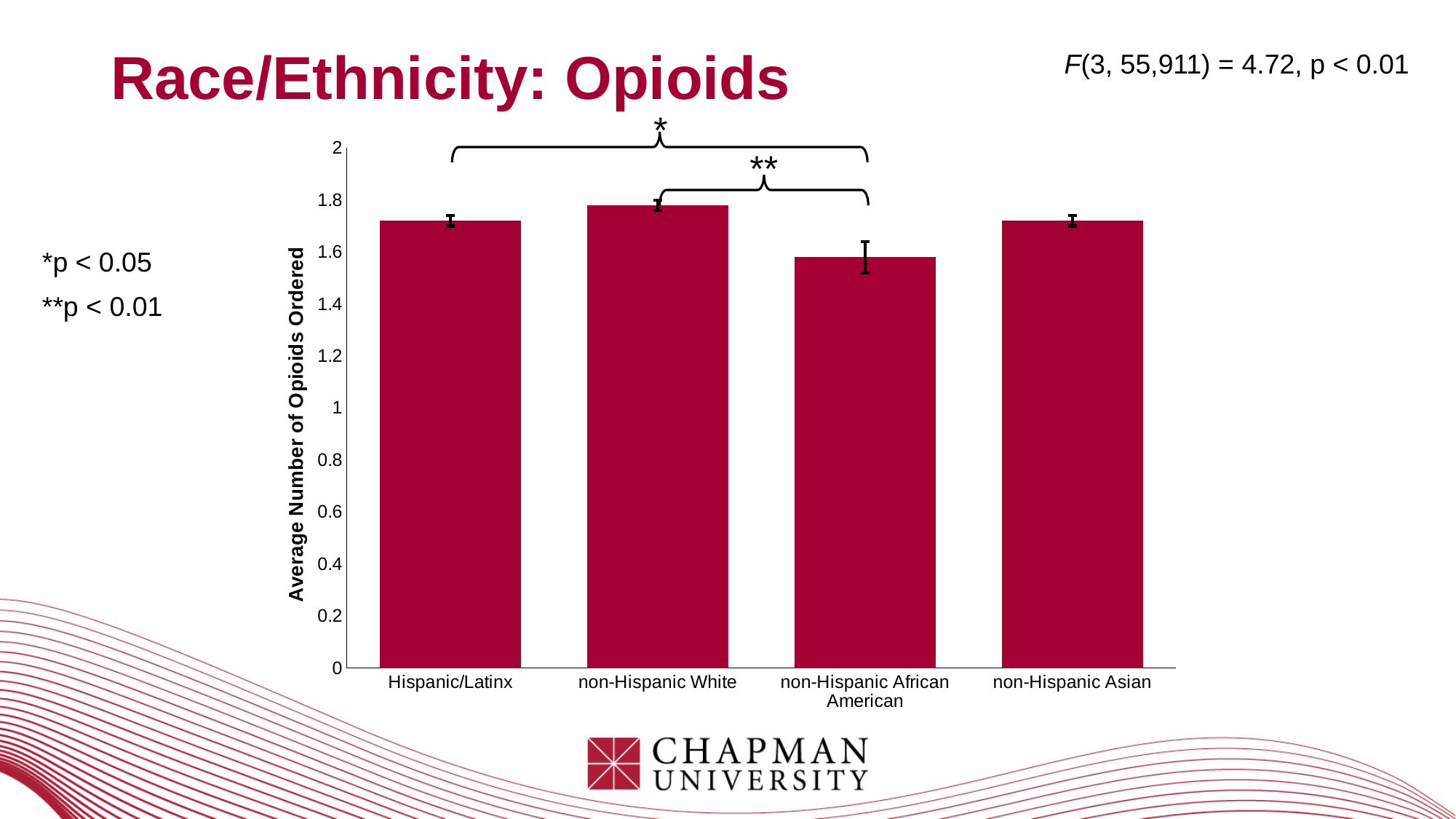
What is the title of the slide containing the chart? Race/Ethnicity: Opioids Which is larger, the value for non-Hispanic White or the value for non-Hispanic African American? non-Hispanic White Which is larger, the value for Hispanic/Latinx or the value for non-Hispanic African American? Hispanic/Latinx Is the value for non-Hispanic Asian greater or less than 1.8? less Is the value for non-Hispanic White greater or less than 1.6? greater How many race/ethnicity categories are plotted in the chart? 4 What is the label of the y axis of the chart? Average Number of Opioids Ordered Is the value for non-Hispanic African American greater or less than 1.4? greater What kind of chart is shown on the slide? bar chart Which category has the lowest average number of opioids ordered? non-Hispanic African American Which category has the highest average number of opioids ordered? non-Hispanic White